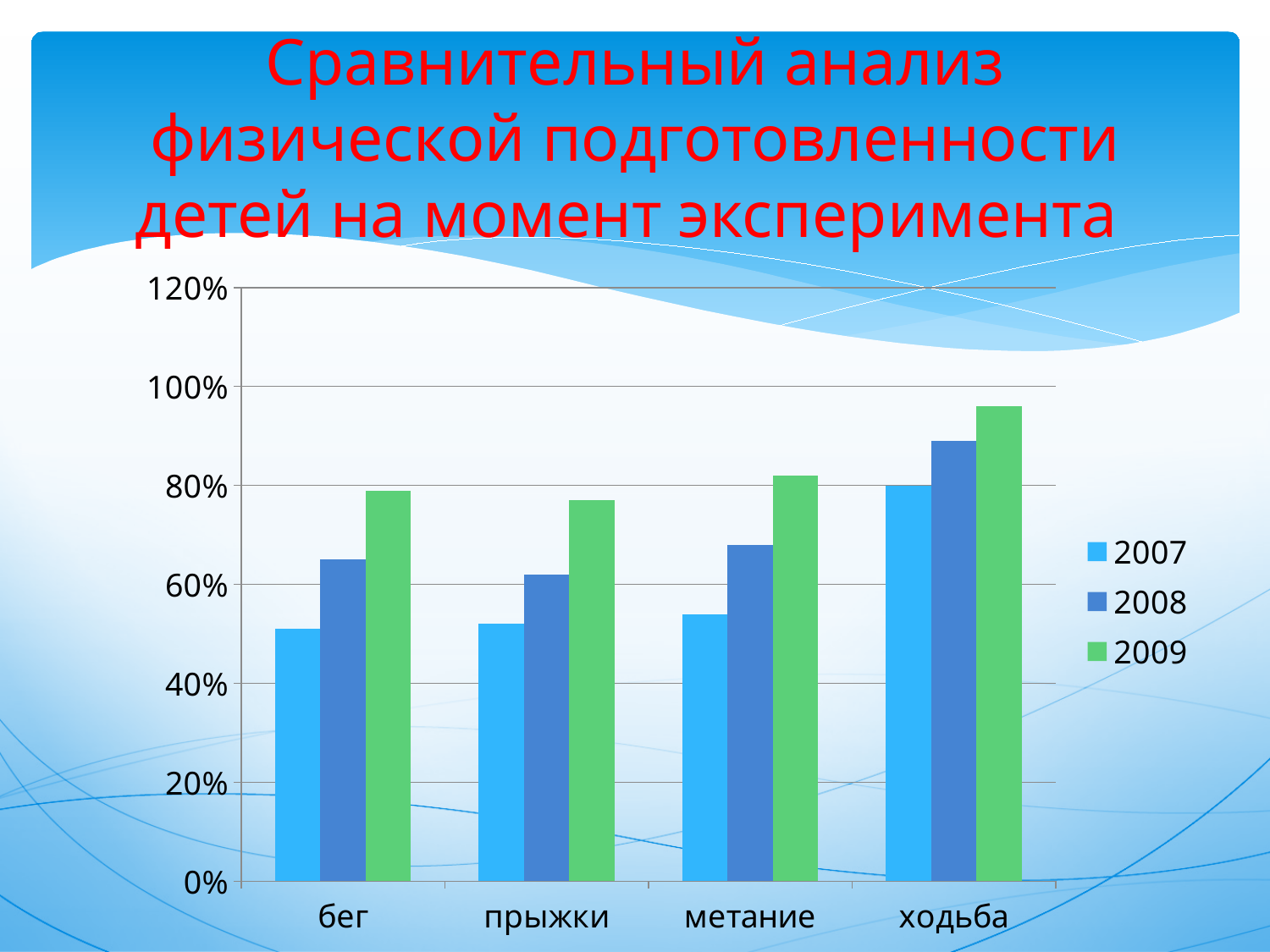
Is the 2007 value for метание greater or less than 60%? less Which is larger, the 2008 value for метание or the 2008 value for прыжки? метание Which series is shown in green in the chart's legend? 2009 Within each category, do the values rise or fall from 2007 to 2009? rise How many categories are shown on the x axis of the chart? 4 Which category has the highest value for the 2007 series? ходьба Is the 2008 value for ходьба greater or less than 80%? greater What kind of chart is shown on the slide? bar chart Is the 2007 value for бег greater or less than 60%? less Which category has the highest value for the 2009 series? ходьба How many series does the chart's legend list? 3